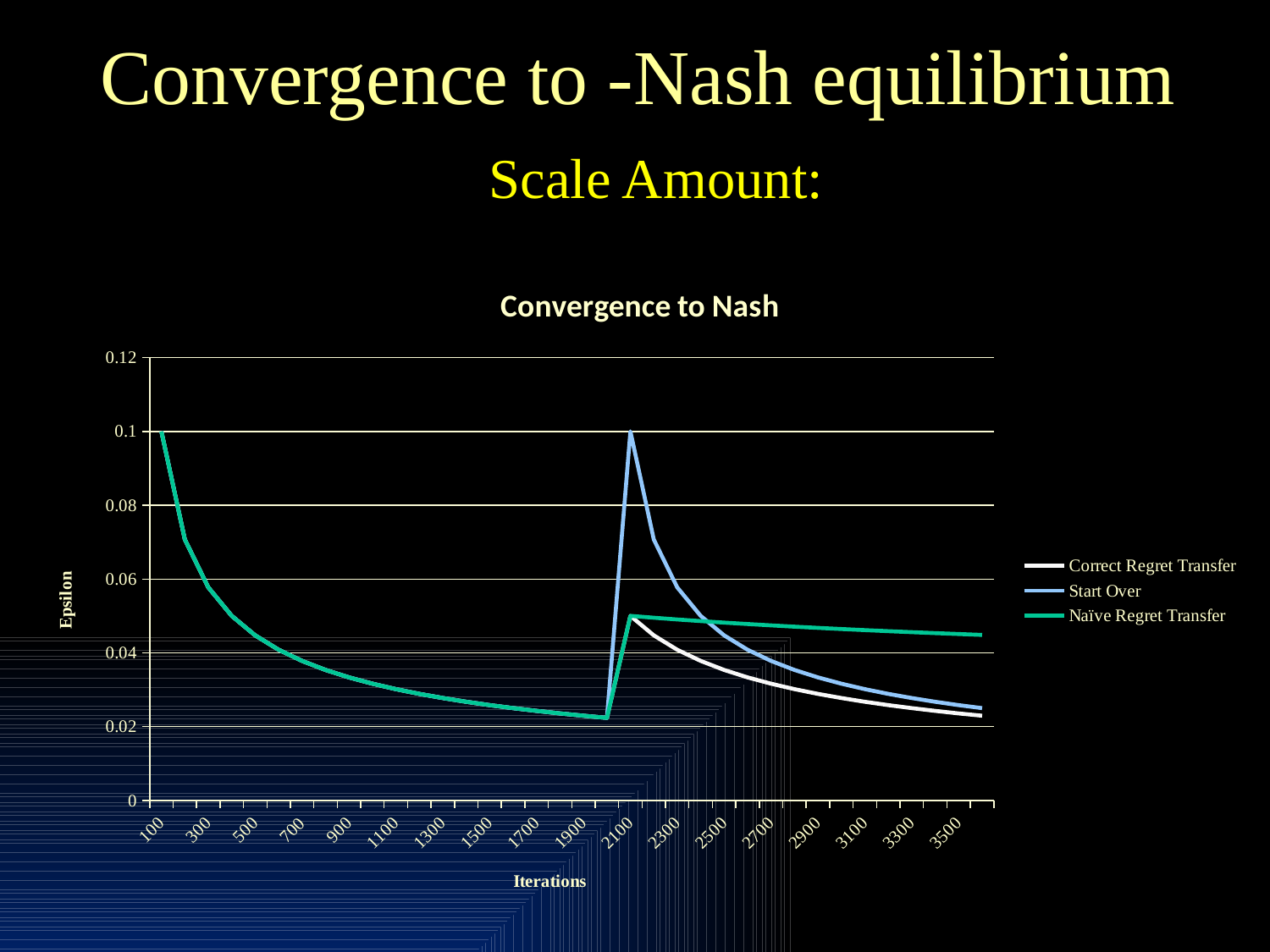
Is the value for Naïve Regret Transfer at 3500 iterations greater or less than 0.04? greater Is the value for Correct Regret Transfer at 3500 iterations greater or less than 0.04? less Does the Naïve Regret Transfer series rise or fall between 100 and 1900 iterations? fall What is the title of the chart? Convergence to Nash How many series does the legend of the chart list? 3 At 2300 iterations, which is larger: Start Over or Naïve Regret Transfer? Start Over Which series has the highest value at 3500 iterations? Naïve Regret Transfer What kind of chart is shown on the slide? line chart Is the value for Naïve Regret Transfer at 1900 iterations greater or less than 0.04? less What is the label of the vertical axis of the chart? Epsilon Which series reaches the highest peak after 2100 iterations? Start Over